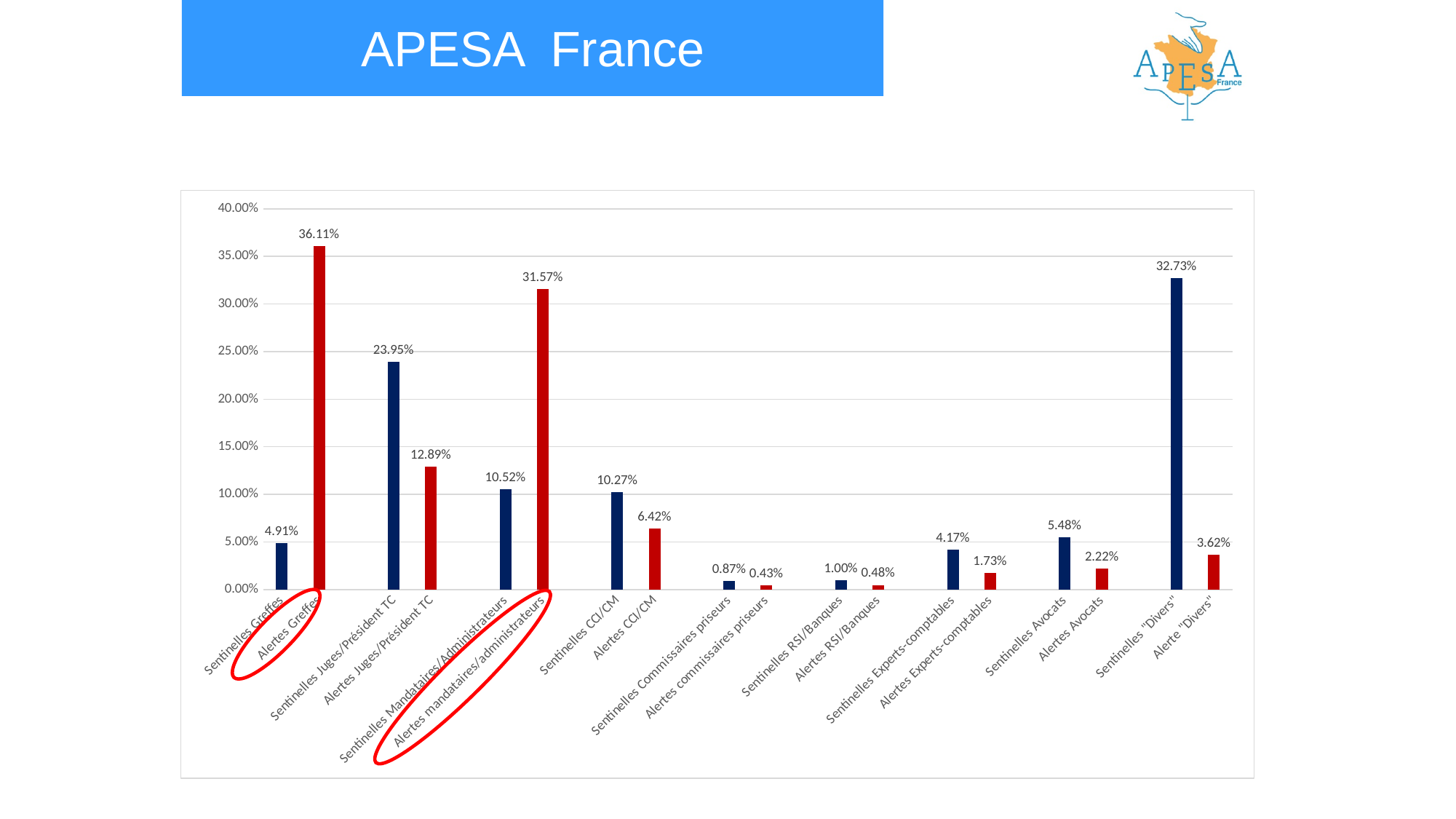
What kind of chart is shown on the slide? Bar chart What is the value for Sentinelles Juges/Président TC? 23.95% What is the value for Sentinelles "Divers"? 32.73% Which category has the highest value? Alertes Greffes Which is larger, Sentinelles CCI/CM or Alertes CCI/CM? Sentinelles CCI/CM What is the value for Alertes mandataires/administrateurs? 31.57% How many categories are shown on the x axis? 18 What is the difference between Alertes Greffes and Alertes mandataires/administrateurs? 4.54% What is the value for Alertes Greffes? 36.11% Which category has the lowest value? Alertes commissaires priseurs What is the value for Alertes RSI/Banques? 0.48% What is the difference between Sentinelles Juges/Président TC and Alertes Juges/Président TC? 11.06%